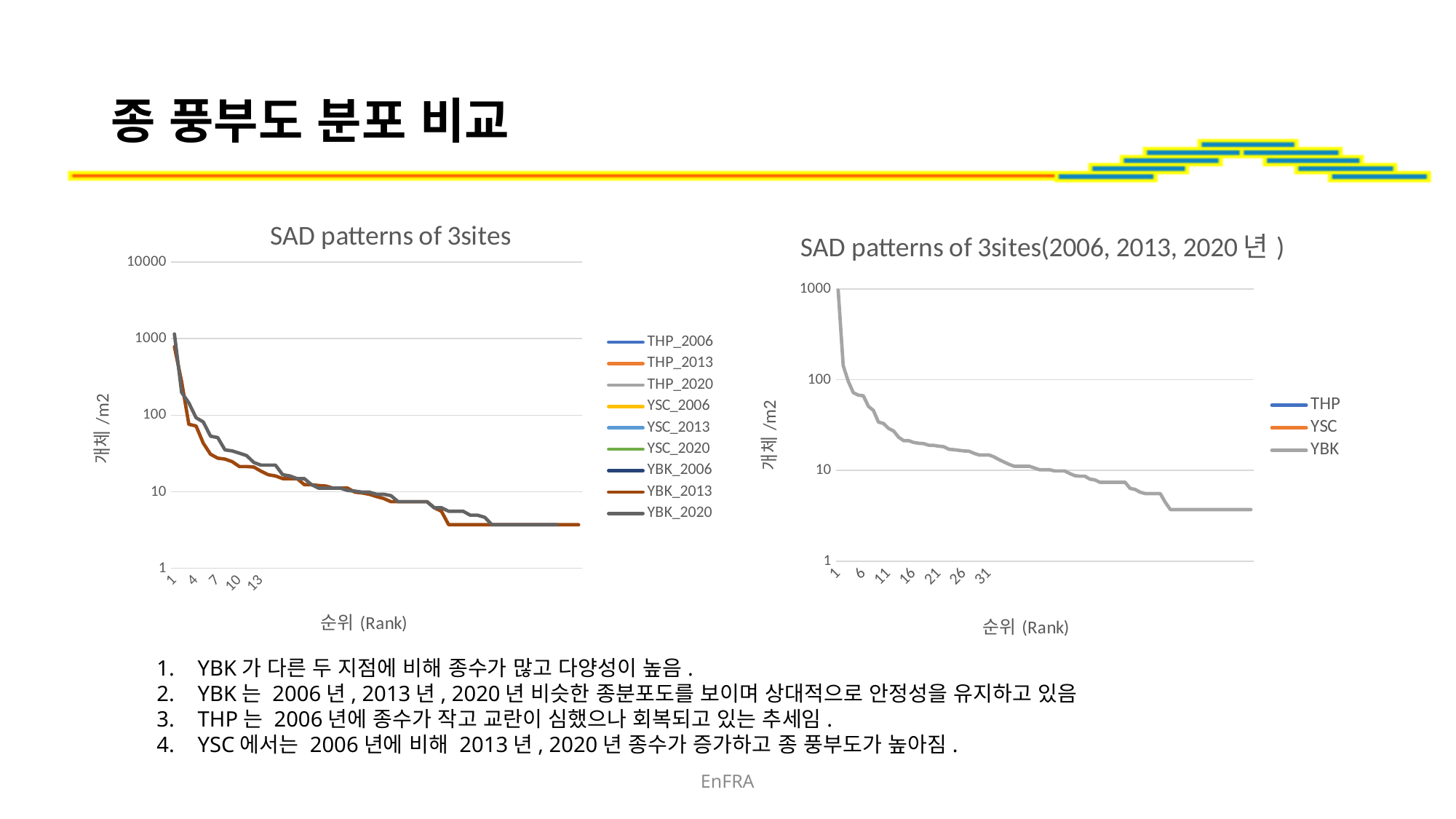
What kind of chart is the right chart titled 'SAD patterns of 3sites(2006, 2013, 2020 년 )'? line chart In the right chart 'SAD patterns of 3sites(2006, 2013, 2020 년 )', is the value for YBK at rank 6 greater or less than 100? less In the left chart 'SAD patterns of 3sites', how many series does the legend list? 9 In the right chart 'SAD patterns of 3sites(2006, 2013, 2020 년 )', do the values rise or fall as rank increases along the x axis? fall In the right chart 'SAD patterns of 3sites(2006, 2013, 2020 년 )', is the value for YBK at rank 6 greater or less than 10? greater In the right chart 'SAD patterns of 3sites(2006, 2013, 2020 년 )', how many series does the legend list? 3 In the left chart 'SAD patterns of 3sites', do the values rise or fall as rank increases along the x axis? fall In the right chart 'SAD patterns of 3sites(2006, 2013, 2020 년 )', is the value for YBK at rank 31 greater or less than 10? greater What is the x-axis label of the left chart 'SAD patterns of 3sites'? 순위 (Rank) In the right chart 'SAD patterns of 3sites(2006, 2013, 2020 년 )', which series is shown in grey in the legend? YBK What kind of chart is the left chart titled 'SAD patterns of 3sites'? line chart